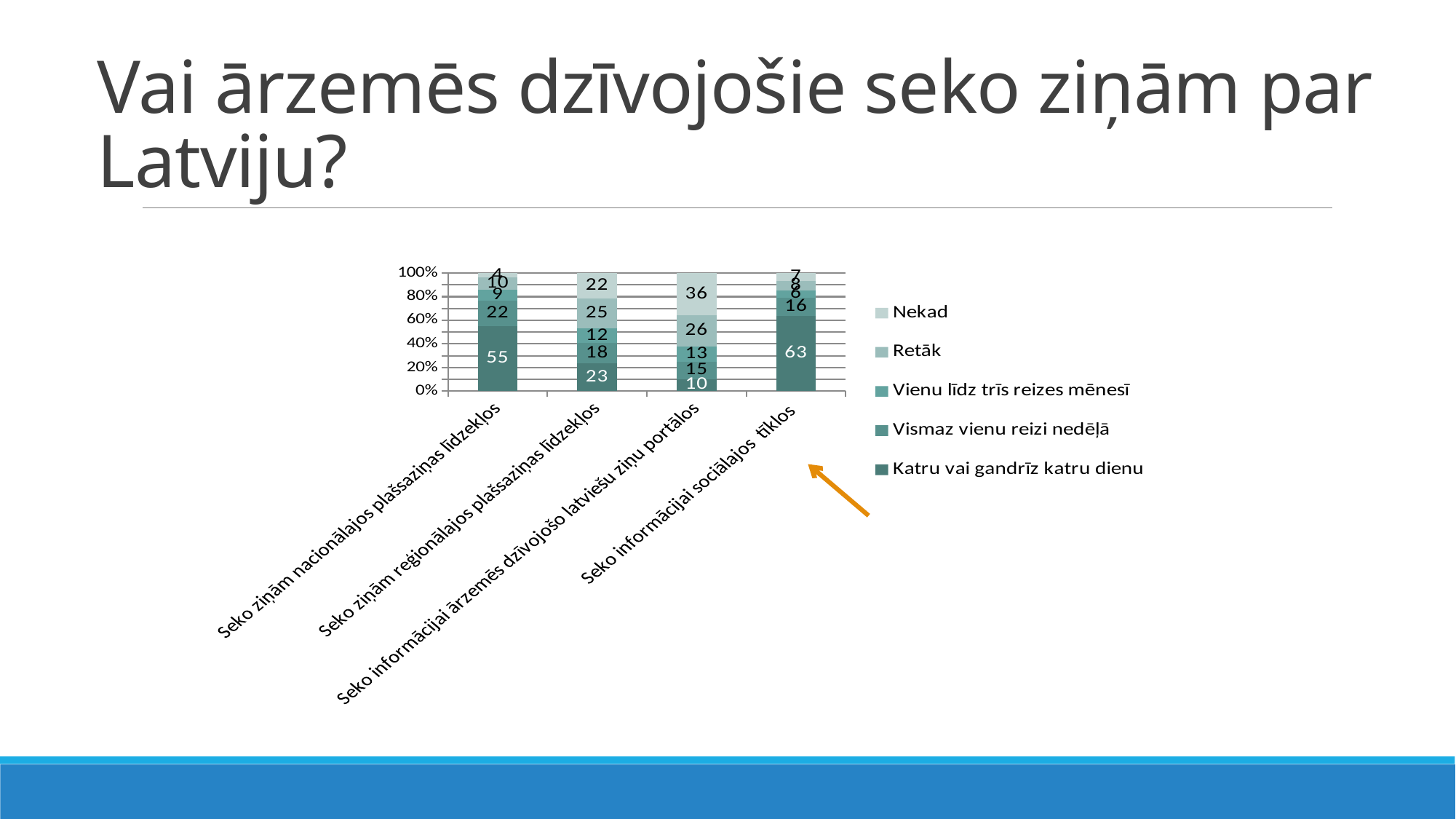
Which is larger: the 'Nekad' value for 'Seko ziņām reģionālajos plašsaziņas līdzekļos' or for 'Seko informācijai ārzemēs dzīvojošo latviešu ziņu portālos'? Seko informācijai ārzemēs dzīvojošo latviešu ziņu portālos What is the difference between the 'Katru vai gandrīz katru dienu' values for 'Seko informācijai sociālajos tīklos' and 'Seko ziņām nacionālajos plašsaziņas līdzekļos'? 8 What is the value of 'Retāk' for 'Seko ziņām reģionālajos plašsaziņas līdzekļos'? 25 How many categories are shown on the x axis of the chart? 4 What kind of chart is shown on the slide? stacked bar chart What is the value of 'Katru vai gandrīz katru dienu' for 'Seko informācijai sociālajos tīklos'? 63 What is the value of 'Nekad' for 'Seko informācijai ārzemēs dzīvojošo latviešu ziņu portālos'? 36 Which category has the lowest value for 'Katru vai gandrīz katru dienu'? Seko informācijai ārzemēs dzīvojošo latviešu ziņu portālos Which legend entry is listed first in the chart legend? Nekad What is the value of 'Katru vai gandrīz katru dienu' for 'Seko ziņām nacionālajos plašsaziņas līdzekļos'? 55 How many series does the chart legend list? 5 Which category has the highest value for 'Katru vai gandrīz katru dienu'? Seko informācijai sociālajos tīklos